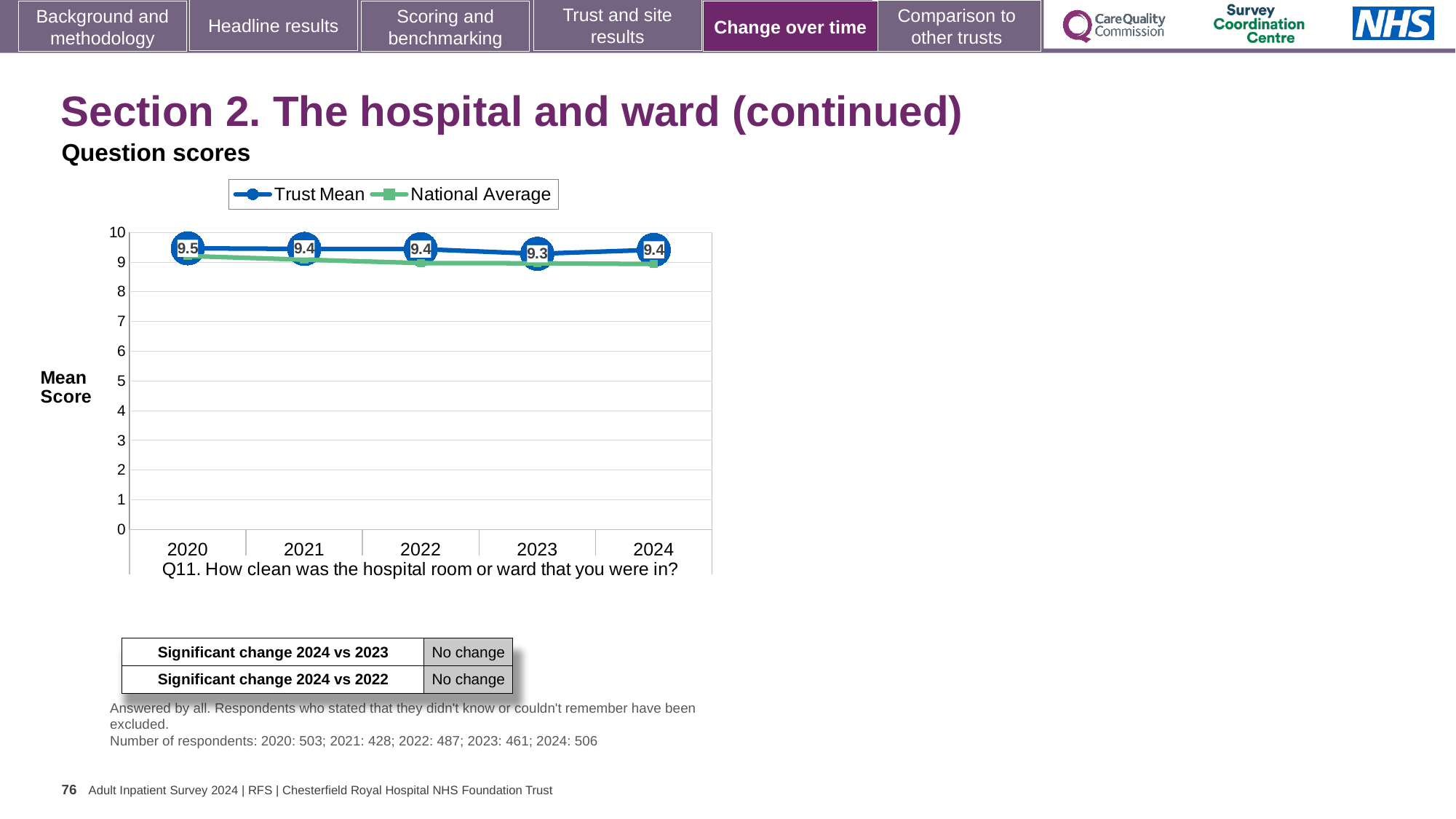
How many series does the legend list? 2 What kind of chart is shown on the slide? Line chart What is the difference between the Trust Mean in 2020 and in 2023? 0.2 What is the Trust Mean value for 2023? 9.3 In which year is the Trust Mean highest? 2020 Which is larger, the Trust Mean in 2020 or in 2023? 2020 Is the National Average value for 2024 greater or less than 8? greater What is the Trust Mean value for 2020? 9.5 In which year is the Trust Mean lowest? 2023 Which survey question does the chart show scores for? Q11. How clean was the hospital room or ward that you were in? How many years are shown on the x axis? 5 What is the Trust Mean value for 2024? 9.4